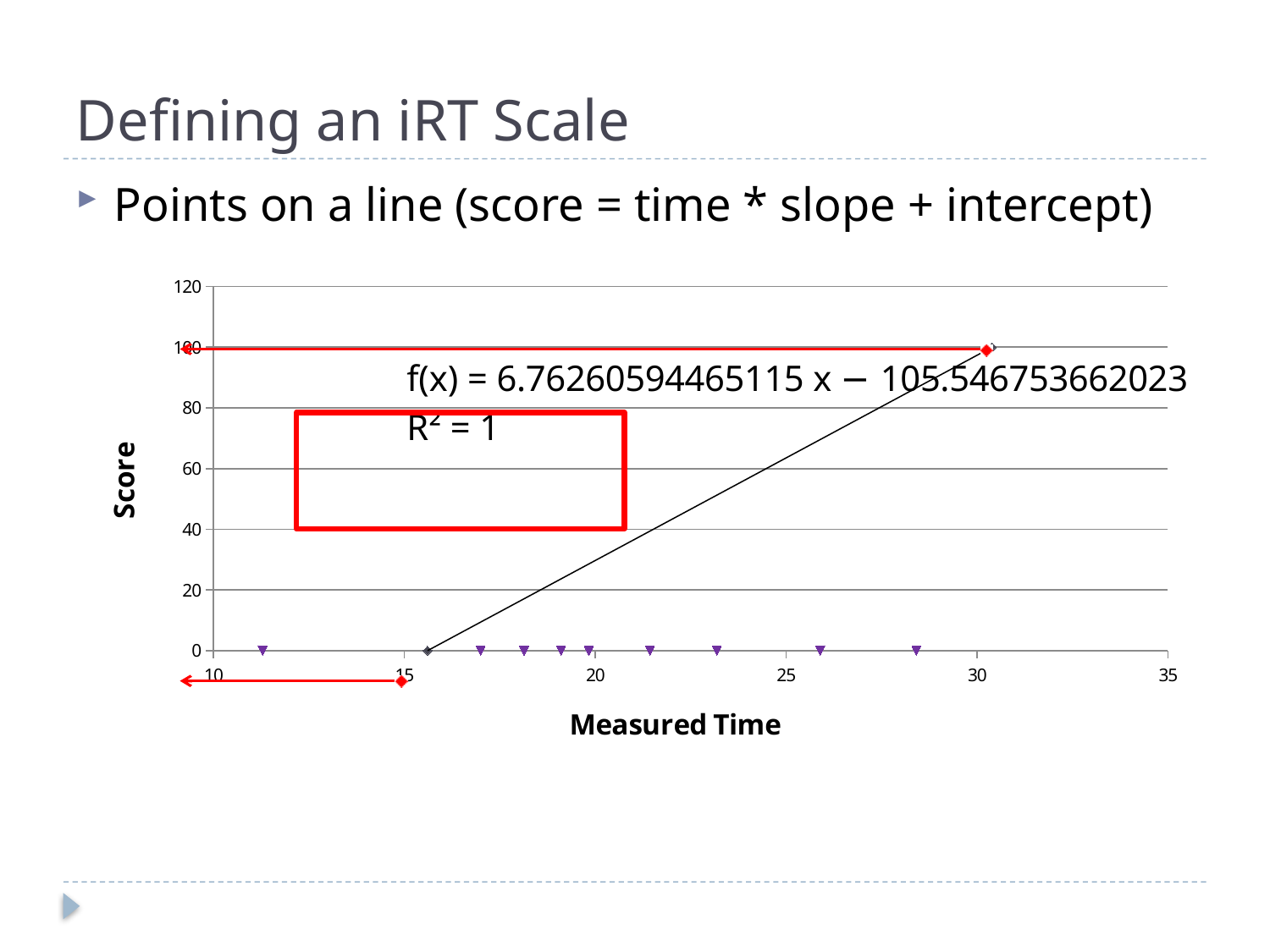
What kind of chart is shown on the slide? scatter chart What R² value is printed for the trendline on the chart? R² = 1 What is the title of the horizontal axis of the chart? Measured Time What is the slope (coefficient of x) in the trendline equation printed on the chart? 6.76260594465115 What is the intercept in the trendline equation printed on the chart? −105.546753662023 Are the Score values of the purple triangle points greater or less than 20? less Does the trendline rise or fall as Measured Time increases? rises What is the full trendline equation printed on the chart? f(x) = 6.76260594465115 x − 105.546753662023 Is the Score of the red diamond point near Measured Time 30 greater or less than 80? greater What is the title of the vertical axis of the chart? Score